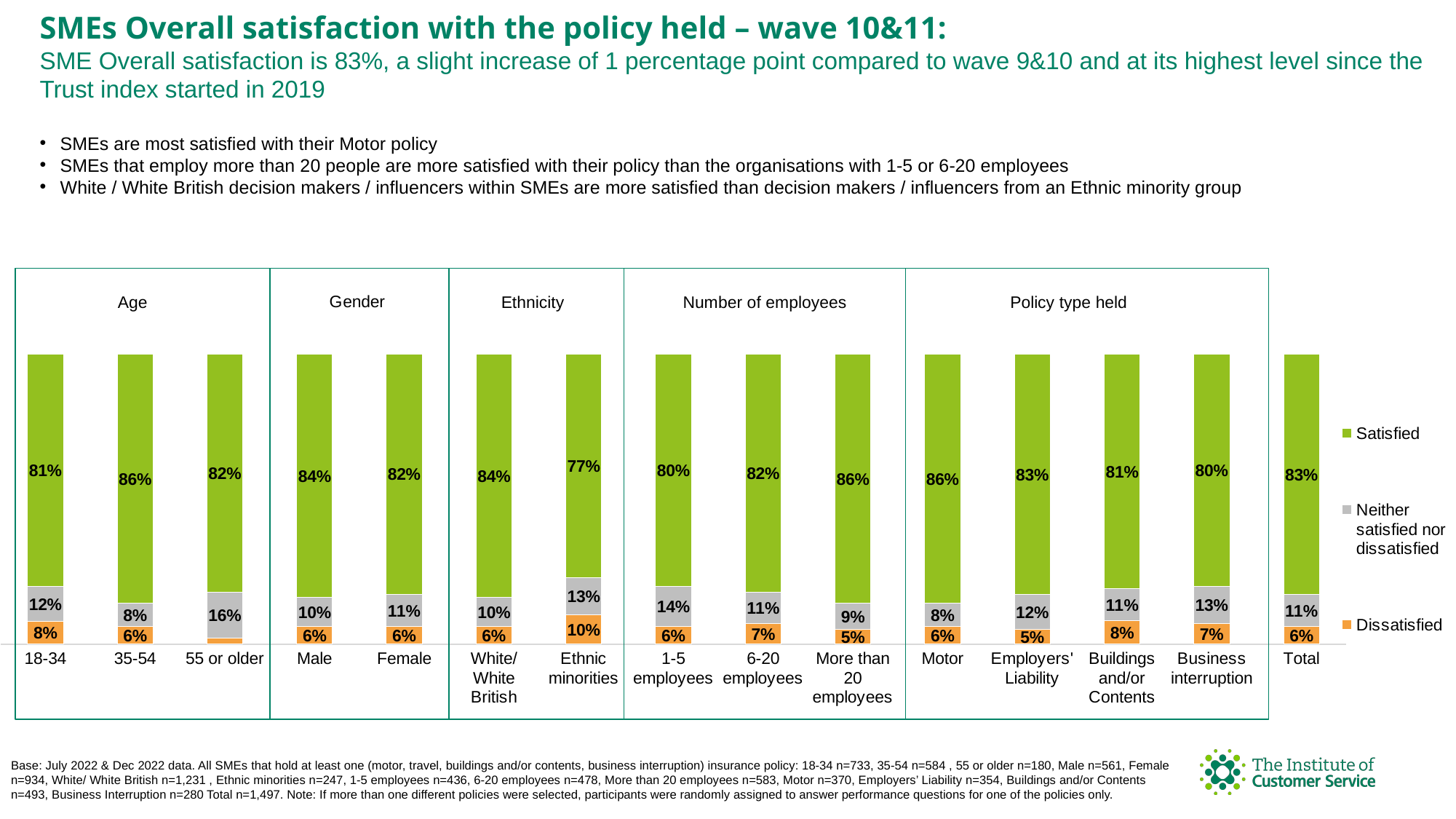
Which ethnicity group has the lowest Satisfied percentage? Ethnic minorities Which policy type held has the highest Satisfied percentage? Motor What percentage of SMEs aged 35-54 are satisfied with the policy held? 86% What is the Satisfied value for the Total bar? 83% What is the difference in Satisfied percentage between White/White British and Ethnic minorities? 7 percentage points How many bars are plotted in the chart, including the Total bar? 15 How many series does the legend list? 3 What is the Dissatisfied value for SMEs with more than 20 employees? 5% Which colour represents the Dissatisfied series in the chart? Orange What is the 'Neither satisfied nor dissatisfied' value for the 55 or older group? 16% Which has a higher Satisfied percentage, Male or Female? Male What kind of chart is shown on the slide? Stacked bar chart